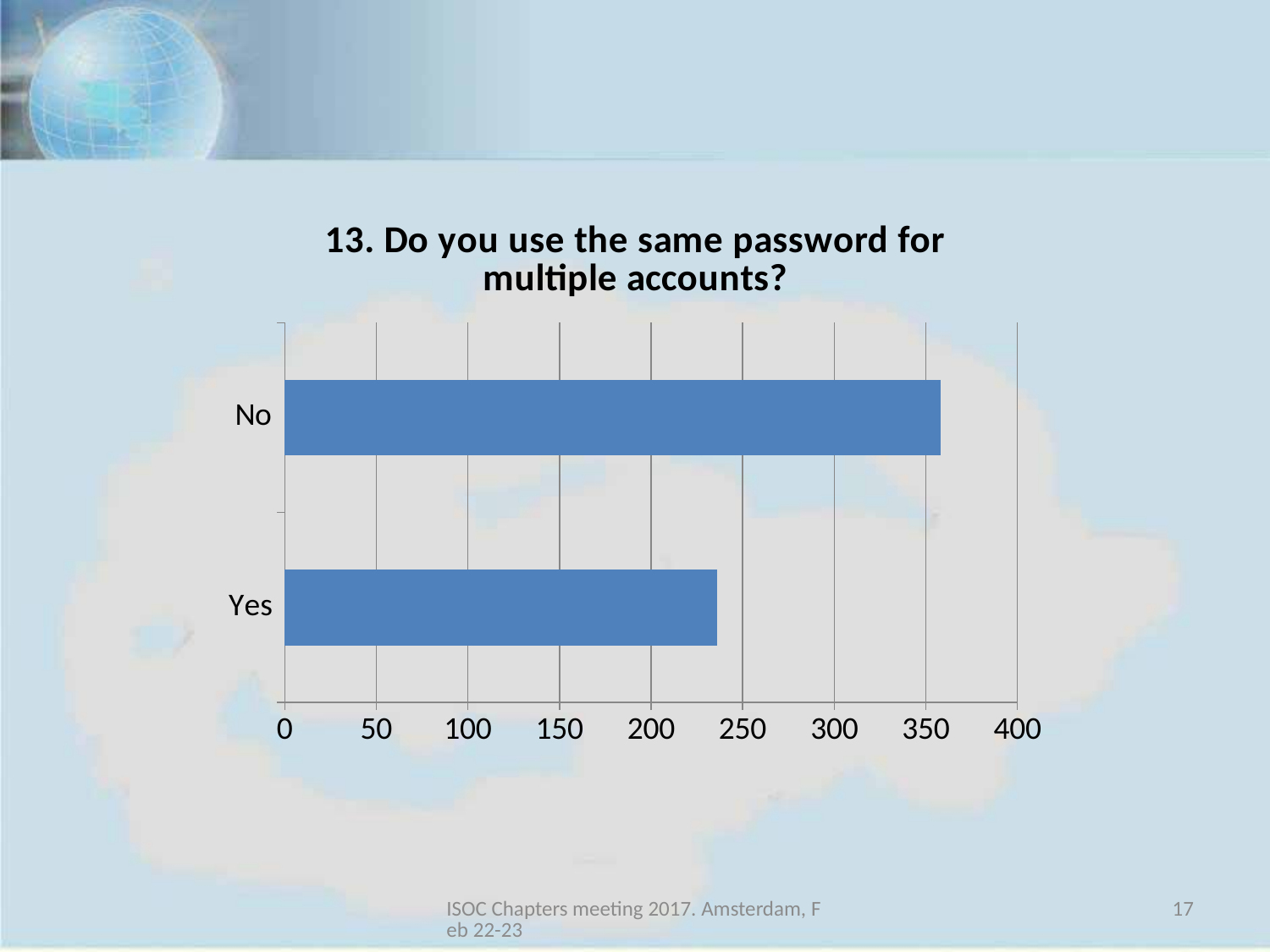
Is the value for Yes greater or less than 250? less Which is larger, the value for No or the value for Yes? No Which category has the highest value? No What is the maximum value shown on the x axis? 400 What type of chart is shown on the slide? bar chart Which category has the lowest value? Yes What is the title of the chart? 13. Do you use the same password for multiple accounts? Is the value for No greater or less than 400? less Is the value for Yes greater or less than 200? greater How many categories are shown in the chart? 2